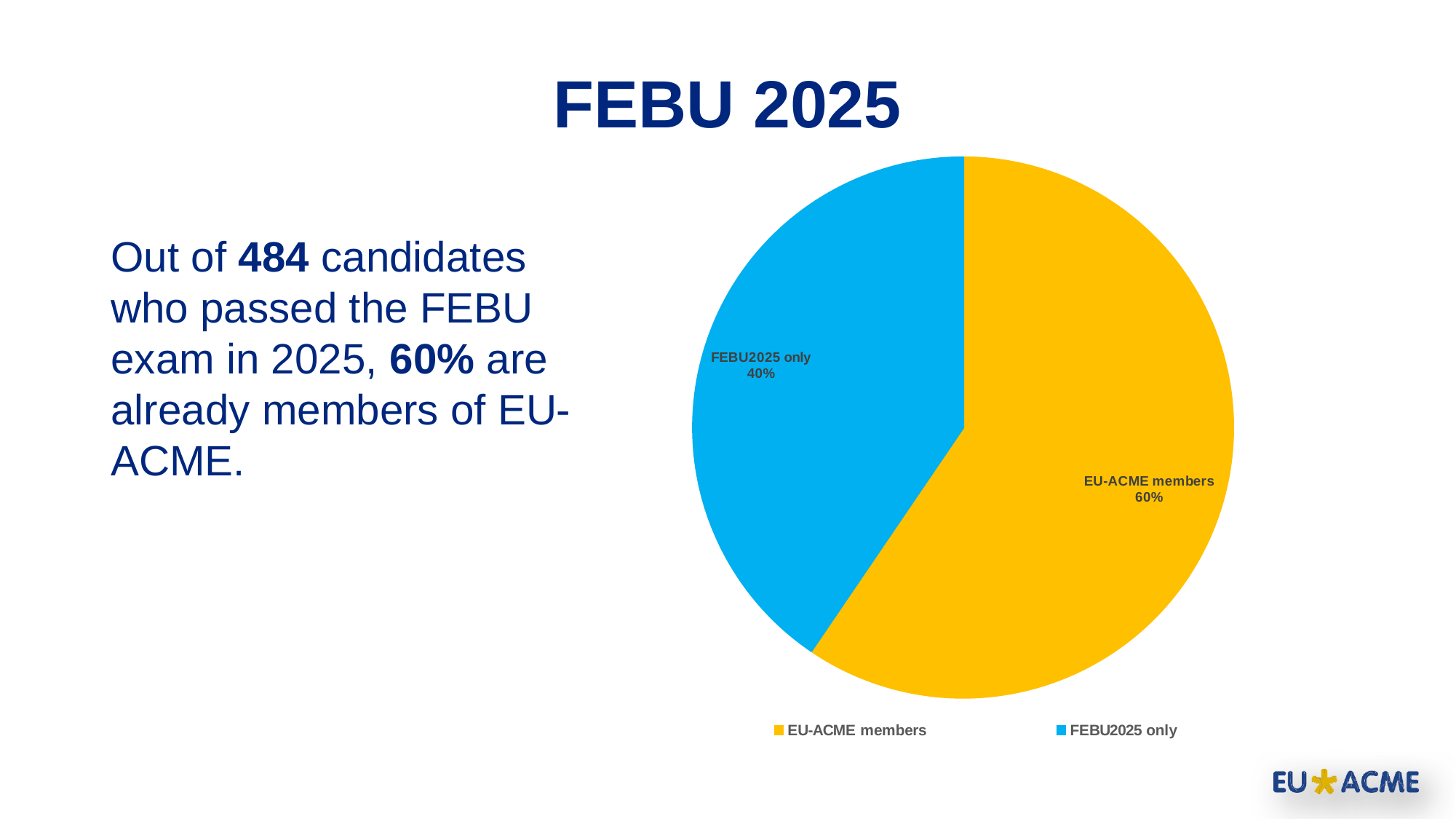
Which slice of the pie is the smallest? FEBU2025 only How many entries does the legend list? 2 What colour is the EU-ACME members slice? yellow What share of the pie is labelled FEBU2025 only? 40% What share of the pie is labelled EU-ACME members? 60% How many slices does the pie chart have? 2 Which is larger, the EU-ACME members slice or the FEBU2025 only slice? EU-ACME members What colour is the FEBU2025 only slice? blue What kind of chart is shown on the slide? pie chart What is the difference in percentage points between the EU-ACME members slice and the FEBU2025 only slice? 20 percentage points Which slice of the pie is the largest? EU-ACME members